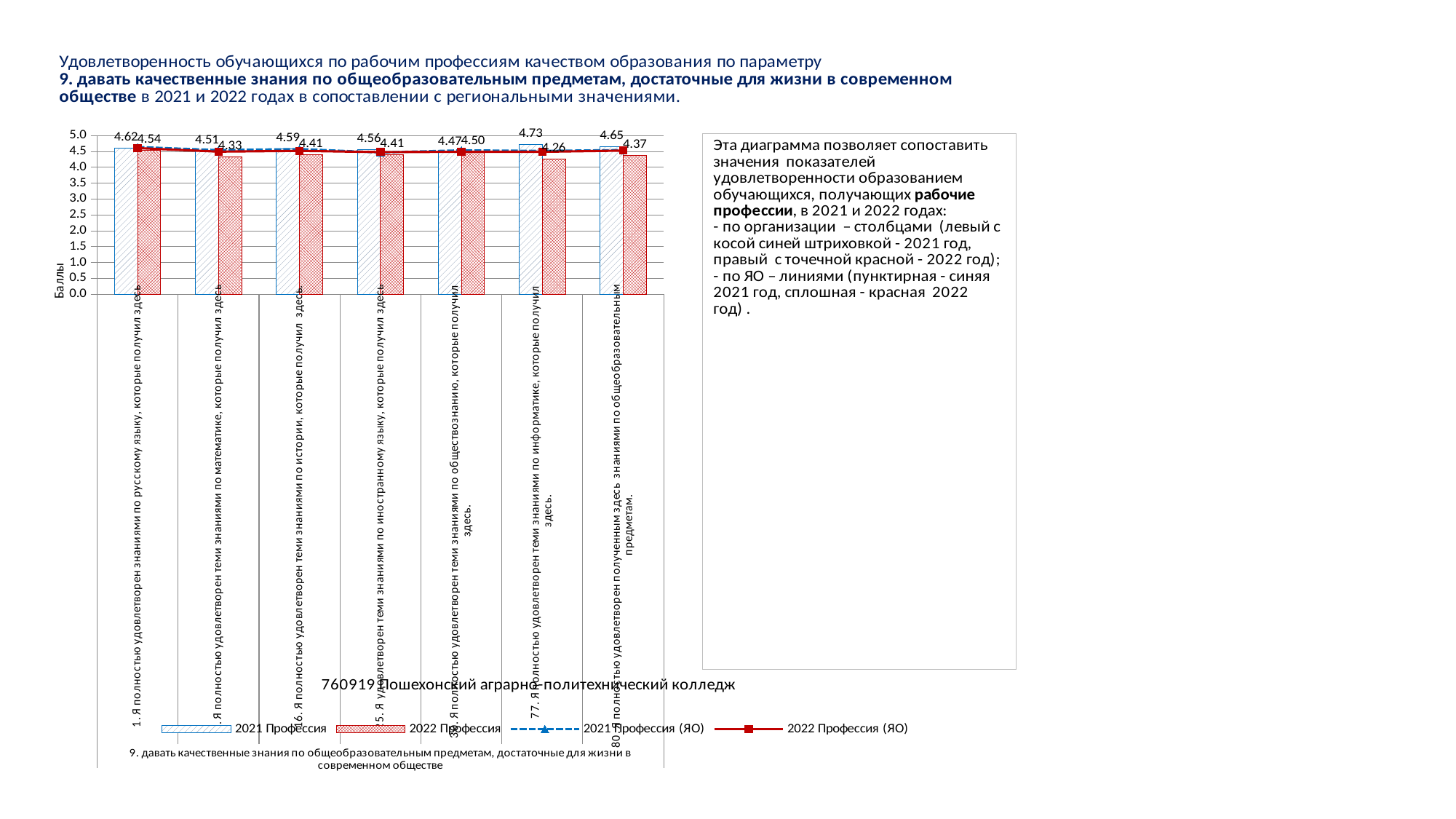
What is the 2021 Профессия value for the category about knowledge of social studies (обществознанию)? 4.47 Which category has the highest 2021 Профессия value? 77. Я полностью удовлетворен теми знаниями по информатике, которые получил здесь. For the social studies (обществознанию) category, which is larger: the 2021 Профессия value or the 2022 Профессия value? 2022 Профессия How many categories are shown on the x axis of the chart? 7 Which category has the lowest 2022 Профессия value? 77. Я полностью удовлетворен теми знаниями по информатике, которые получил здесь. What is the 2021 Профессия value for the category about knowledge of Russian language (русскому языку)? 4.62 What is the 2022 Профессия value for the category about knowledge of mathematics (математике)? 4.33 What is the 2022 Профессия value for the category about knowledge of informatics (информатике)? 4.26 What is the difference between the 2021 Профессия and 2022 Профессия values for the informatics (информатике) category? 0.47 What is the label of the vertical axis of the chart? Баллы How many series does the chart legend list? 4 What kind of chart is shown on the slide? Combined bar and line chart